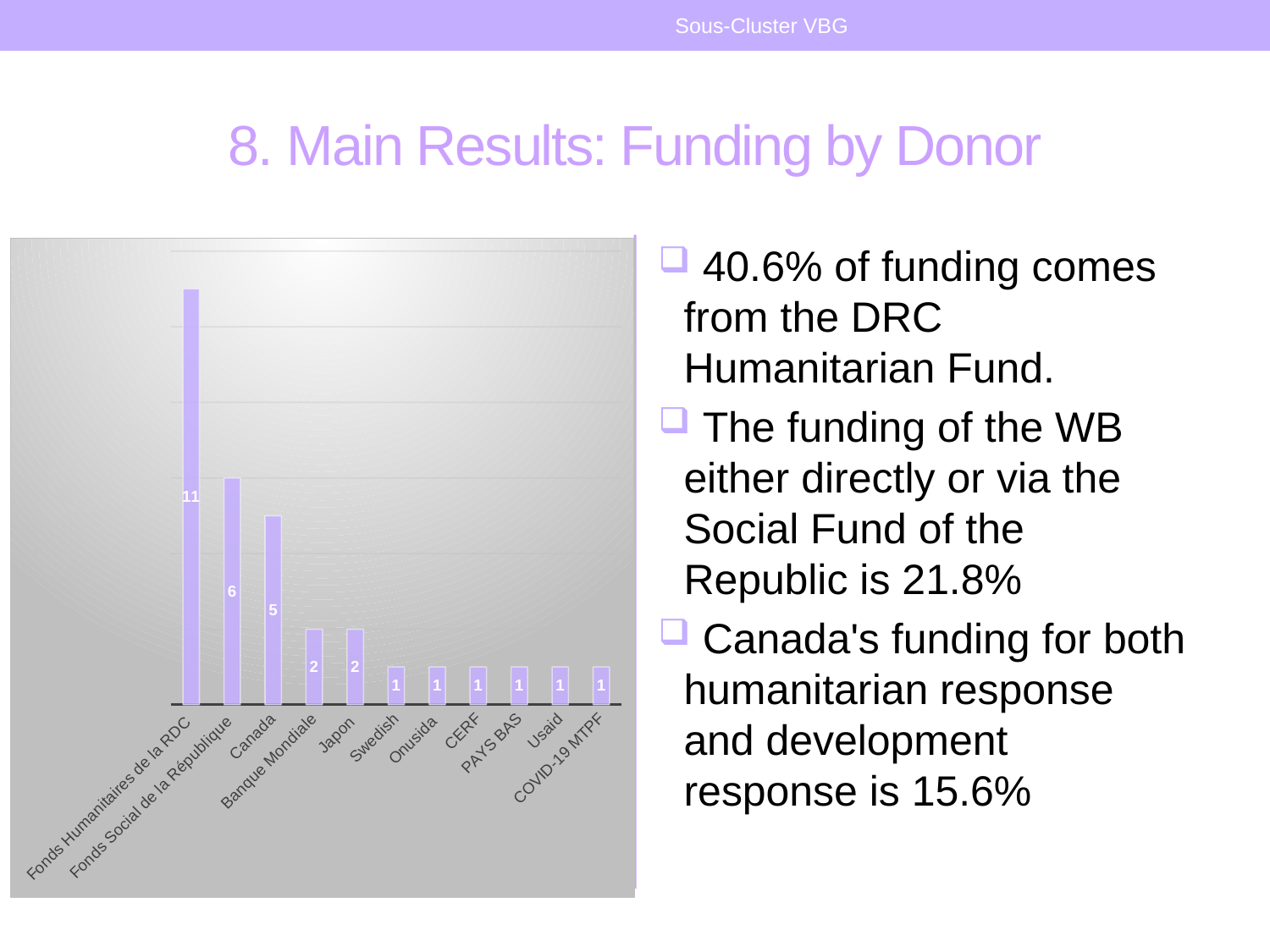
What is the value for Fonds Humanitaires de la RDC? 11 What is the value for Banque Mondiale? 2 What is the value for Fonds Social de la République? 6 What kind of chart is shown on the slide? Bar chart What is the difference between the values for Fonds Humanitaires de la RDC and Fonds Social de la République? 5 How many categories are shown on the x axis? 11 Which category has the highest value? Fonds Humanitaires de la RDC Do the values rise or fall from left to right along the x axis? Fall What is the value for Canada? 5 What is the difference between the values for Canada and Japon? 3 What is the value for CERF? 1 Which is larger, the value for Canada or the value for Banque Mondiale? Canada